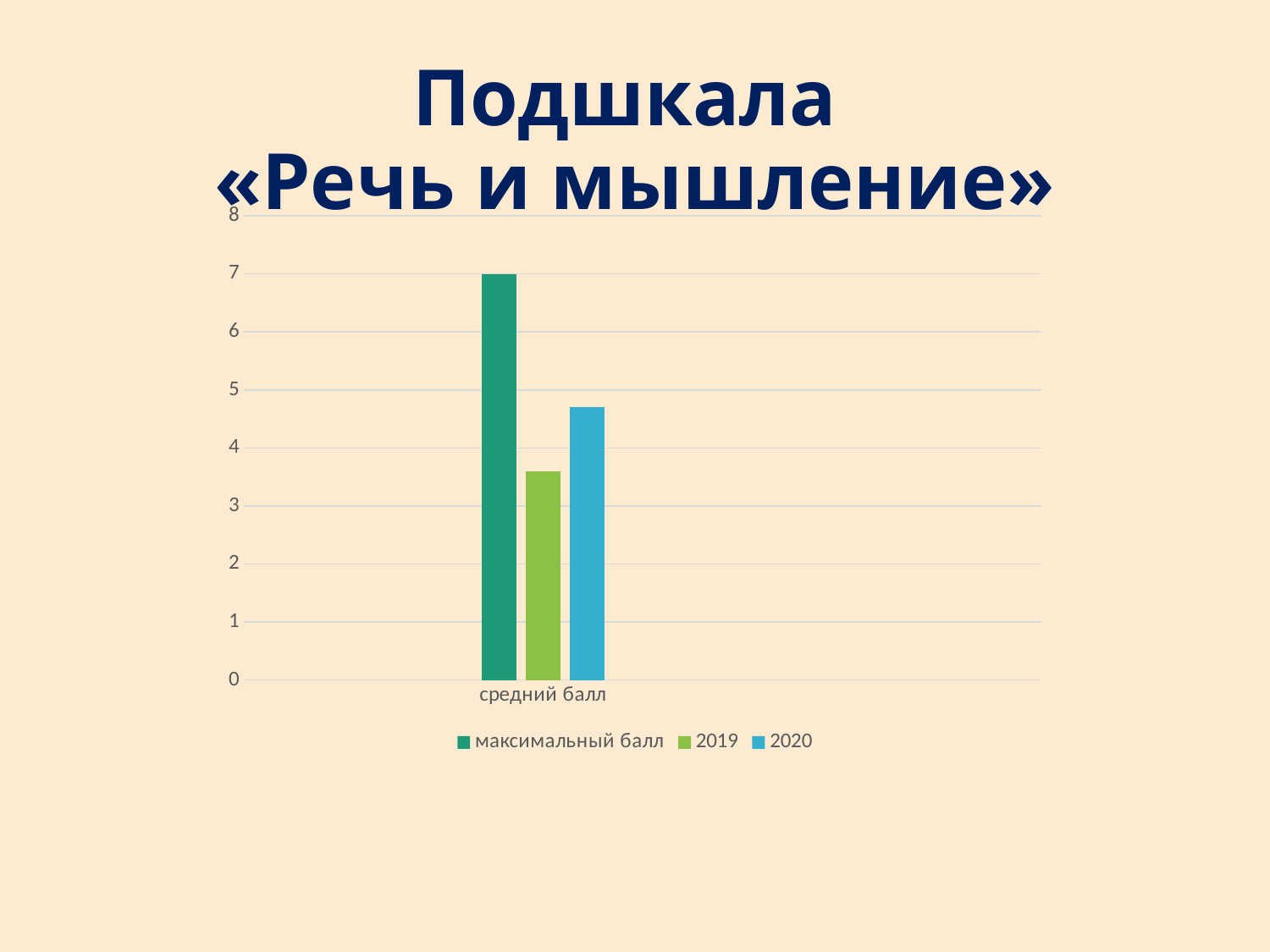
Is the value for 2019 greater or less than 3? greater How many categories are shown on the x axis? 1 What is the title of the slide above the chart? Подшкала «Речь и мышление» Which series has the shortest bar? 2019 Which is larger, the value for 2019 or the value for 2020? 2020 Is the value for 2019 greater or less than 4? less What kind of chart is shown on the slide? bar chart Is the value for 2020 greater or less than 4? greater What is the value of the 'максимальный балл' bar? 7 How many series does the legend list? 3 Which series has the tallest bar? максимальный балл